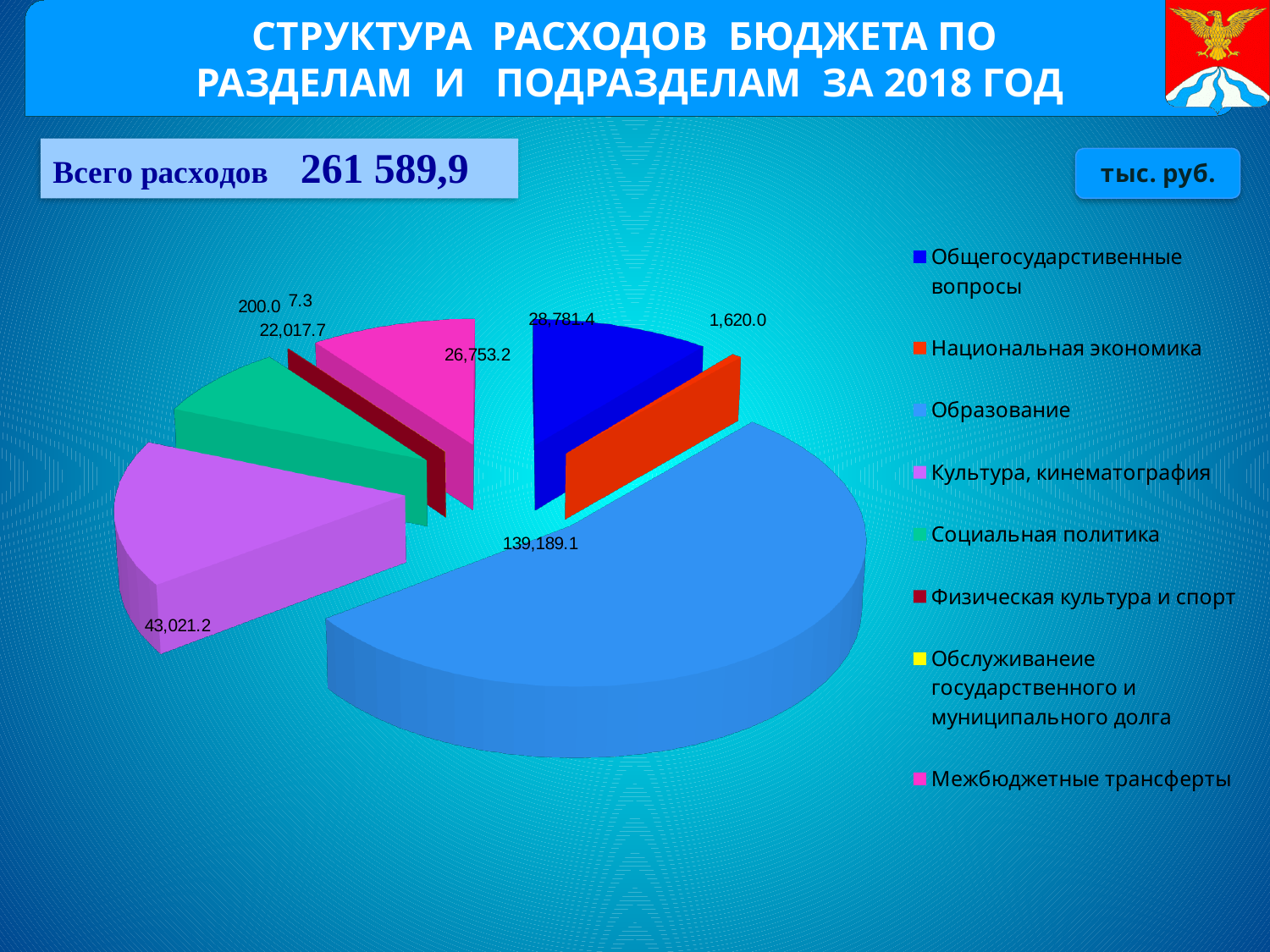
What is the difference between Культура, кинематография and Социальная политика? 21,003.5 What is the value for Культура, кинематография? 43,021.2 Which category has the smallest value? Обслуживание государственного и муниципального долга How many categories does the legend list? 8 What total expenditure figure is shown on the slide? 261 589,9 Which category has the largest slice of the pie? Образование What is the value for Обслуживание государственного и муниципального долга? 7.3 What kind of chart is shown on the slide? pie chart What is the value for Социальная политика? 22,017.7 What is the value for Образование? 139,189.1 What is the value for Межбюджетные трансферты? 26,753.2 Which is larger, Культура, кинематография or Социальная политика? Культура, кинематография